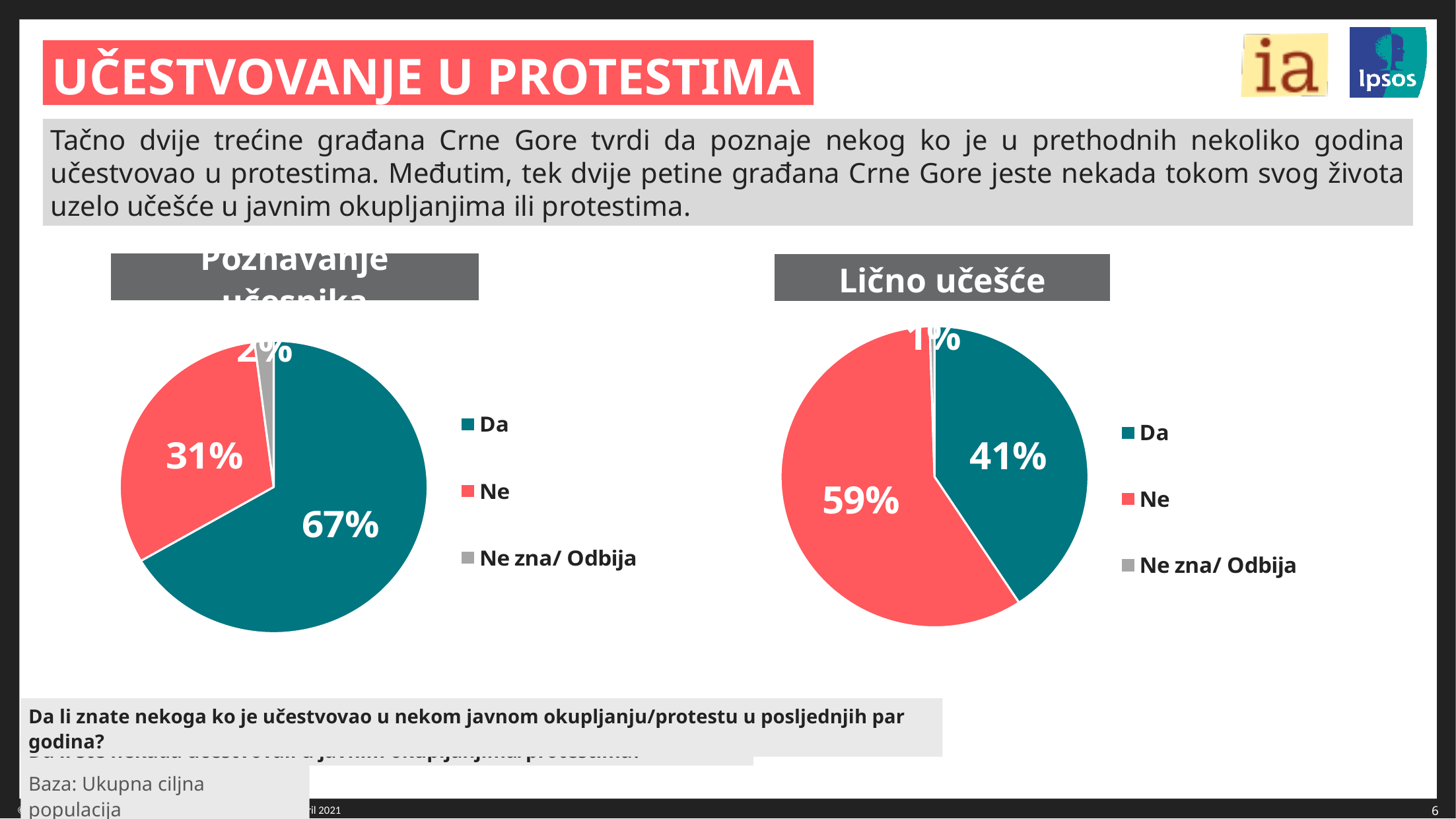
In the left pie chart (Poznavanje učesnika), what is the value for "Da"? 67% In the left pie chart (Poznavanje učesnika), what is the difference between the "Da" and "Ne" shares? 36 percentage points How many categories does the legend of the "Lično učešće" pie chart list? 3 What type of chart is used for "Lično učešće"? Pie chart In the "Lično učešće" pie chart, what is the value for "Ne"? 59% In the left pie chart (Poznavanje učesnika), what is the value for "Ne zna/ Odbija"? 2% In the "Lično učešće" pie chart, what is the difference between the "Ne" and "Da" shares? 18 percentage points In the left pie chart (Poznavanje učesnika), what is the value for "Ne"? 31% In the left pie chart (Poznavanje učesnika), which category has the smallest share? Ne zna/ Odbija In the "Lično učešće" pie chart, which category has the largest share? Ne Which is larger: the "Da" share in the left pie chart or the "Da" share in the "Lično učešće" pie chart? The left pie chart (67%) In the "Lično učešće" pie chart, what is the value for "Da"? 41%